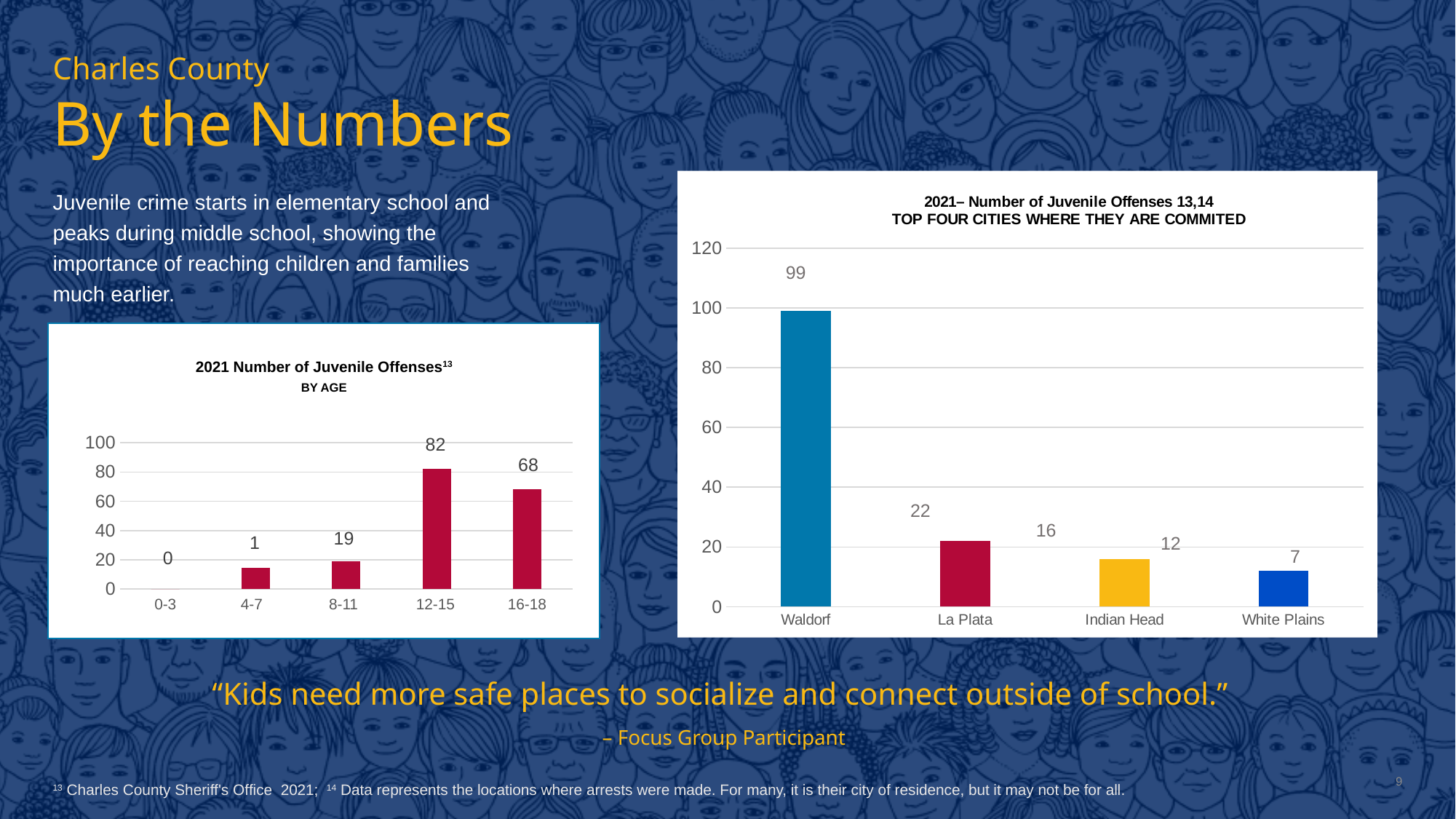
In the chart titled '2021 Number of Juvenile Offenses BY AGE', what is the difference between the values for 12-15 and 16-18? 14 In the chart titled '2021 Number of Juvenile Offenses BY AGE', how many age groups are shown? 5 In the chart titled '2021 Number of Juvenile Offenses BY AGE', which age group has the lowest number of offenses? 0-3 In the chart titled '2021 Number of Juvenile Offenses BY AGE', which age group has the highest number of offenses? 12-15 In the chart titled '2021 Number of Juvenile Offenses BY AGE', what is the value for the 12-15 age group? 82 In the chart titled 'TOP FOUR CITIES WHERE THEY ARE COMMITED', what is the value for Indian Head? 16 What kind of chart is the one titled 'TOP FOUR CITIES WHERE THEY ARE COMMITED'? Bar chart In the chart titled 'TOP FOUR CITIES WHERE THEY ARE COMMITED', which city has the lowest number of offenses? White Plains In the chart titled '2021 Number of Juvenile Offenses BY AGE', what is the value for the 16-18 age group? 68 In the chart titled 'TOP FOUR CITIES WHERE THEY ARE COMMITED', what is the difference between the values for Waldorf and La Plata? 77 In the chart titled 'TOP FOUR CITIES WHERE THEY ARE COMMITED', which is larger, the value for La Plata or the value for White Plains? La Plata In the chart titled 'TOP FOUR CITIES WHERE THEY ARE COMMITED', what is the value for Waldorf? 99